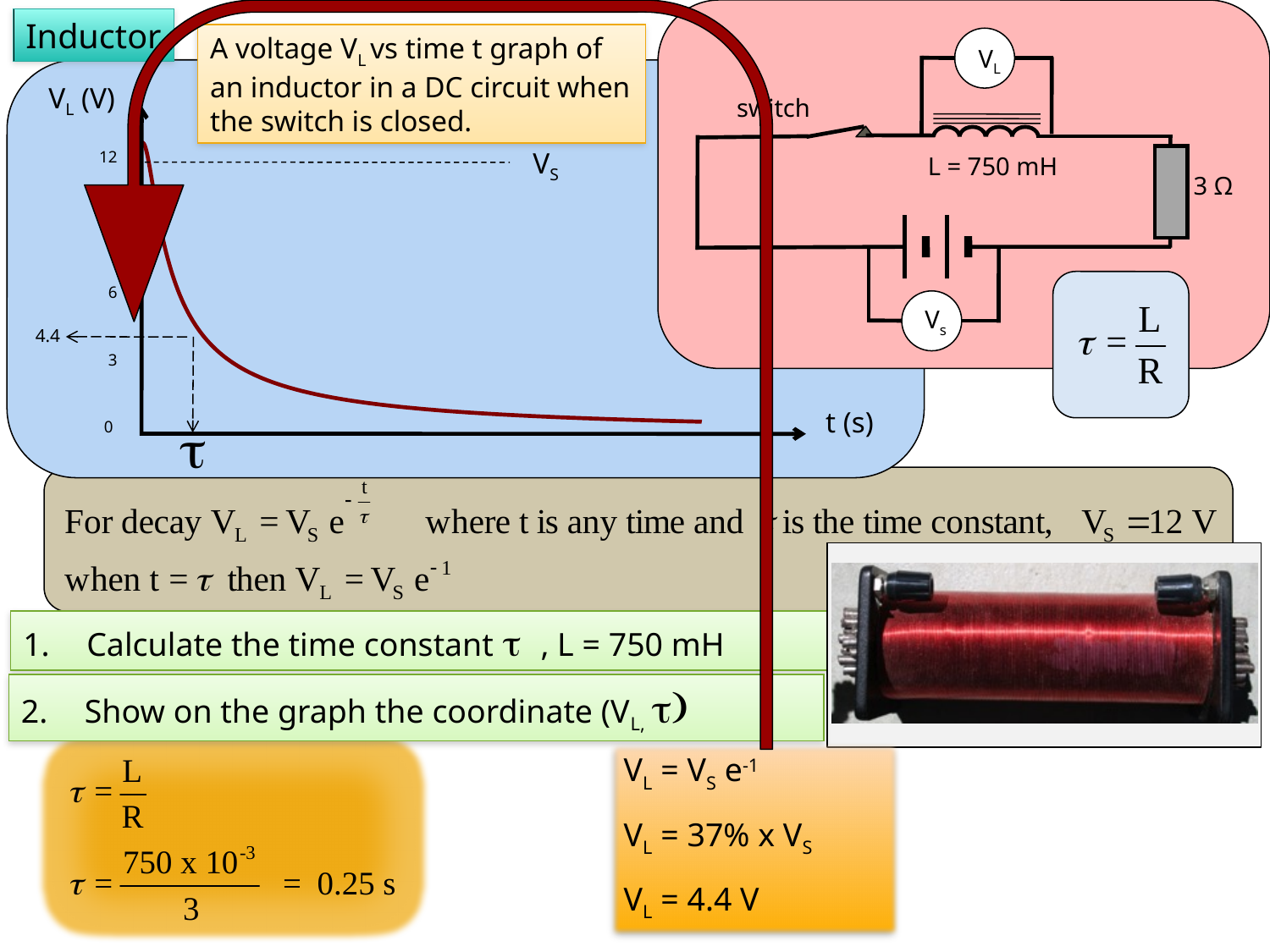
What is the difference between V_S and the value of V_L at t = τ, as marked on the vertical axis? 7.6 Which is larger, V_S or the value of V_L at t = τ? V_S Does the plotted voltage V_L rise or fall as time t increases? fall What kind of chart is shown on the slide? line chart How many curves are plotted on the graph? 1 What value of V_L is marked on the vertical axis at t = τ? 4.4 What value on the vertical axis does the dashed line labelled V_S correspond to? 12 Is the value of V_L at t = τ greater or less than 6? less What is the highest tick value shown on the vertical axis of the graph? 12 What is the label of the vertical axis of the graph? V_L (V) What is the label of the horizontal axis of the graph? t (s) Is the value of V_L at t = τ greater or less than 3? greater